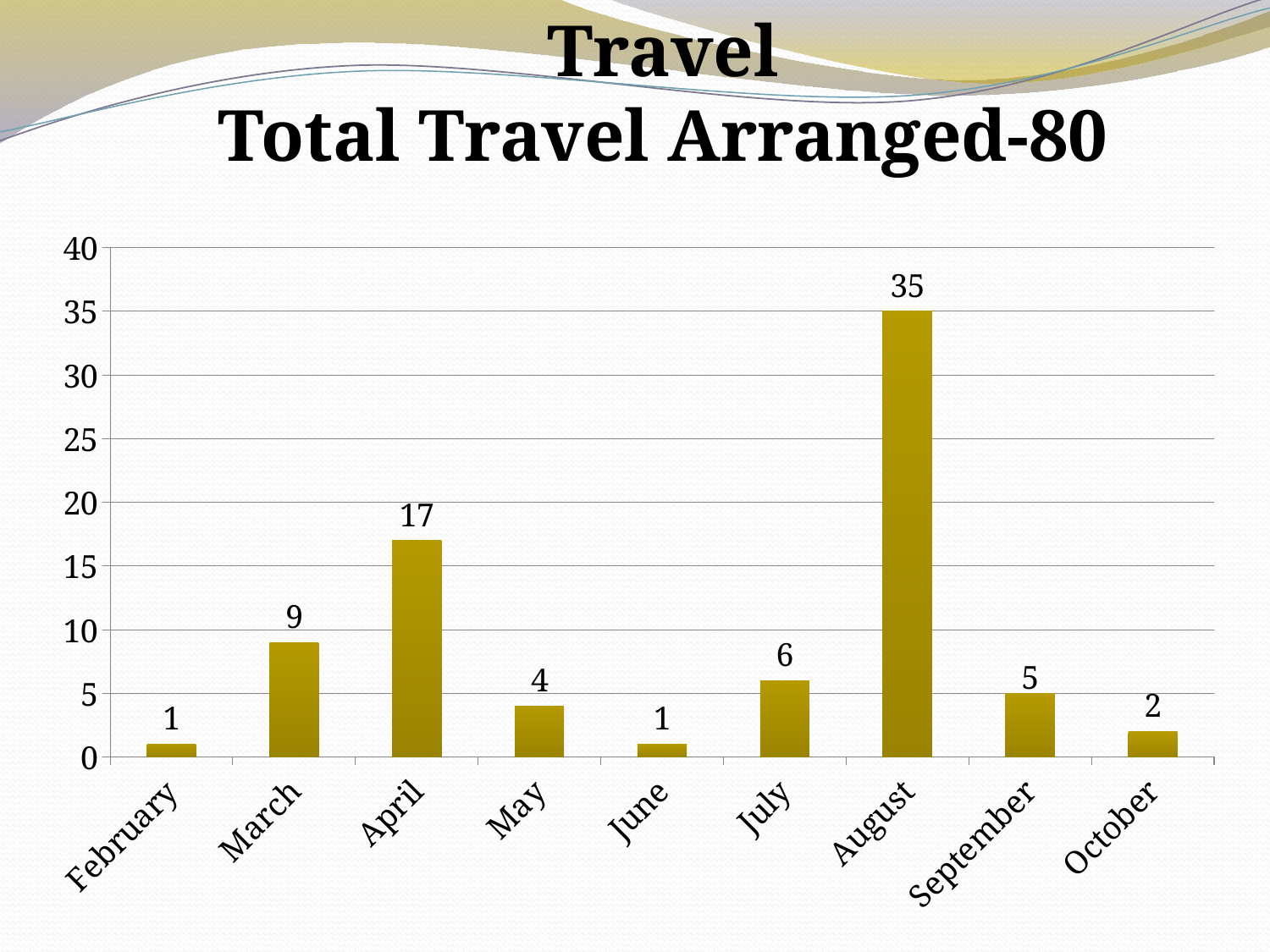
What is the difference between the values for August and April? 18 Which is larger, the value for July or the value for October? July Which month has the highest value? August What is the value for April? 17 What is the difference between the values for March and May? 5 What is the value for August? 35 What is the value for September? 5 How many months are shown on the x axis? 9 What kind of chart is shown on the slide? bar chart What is the title of the slide? Travel Total Travel Arranged-80 Which months share the lowest value? February and June Is the value for August greater or less than 30? greater